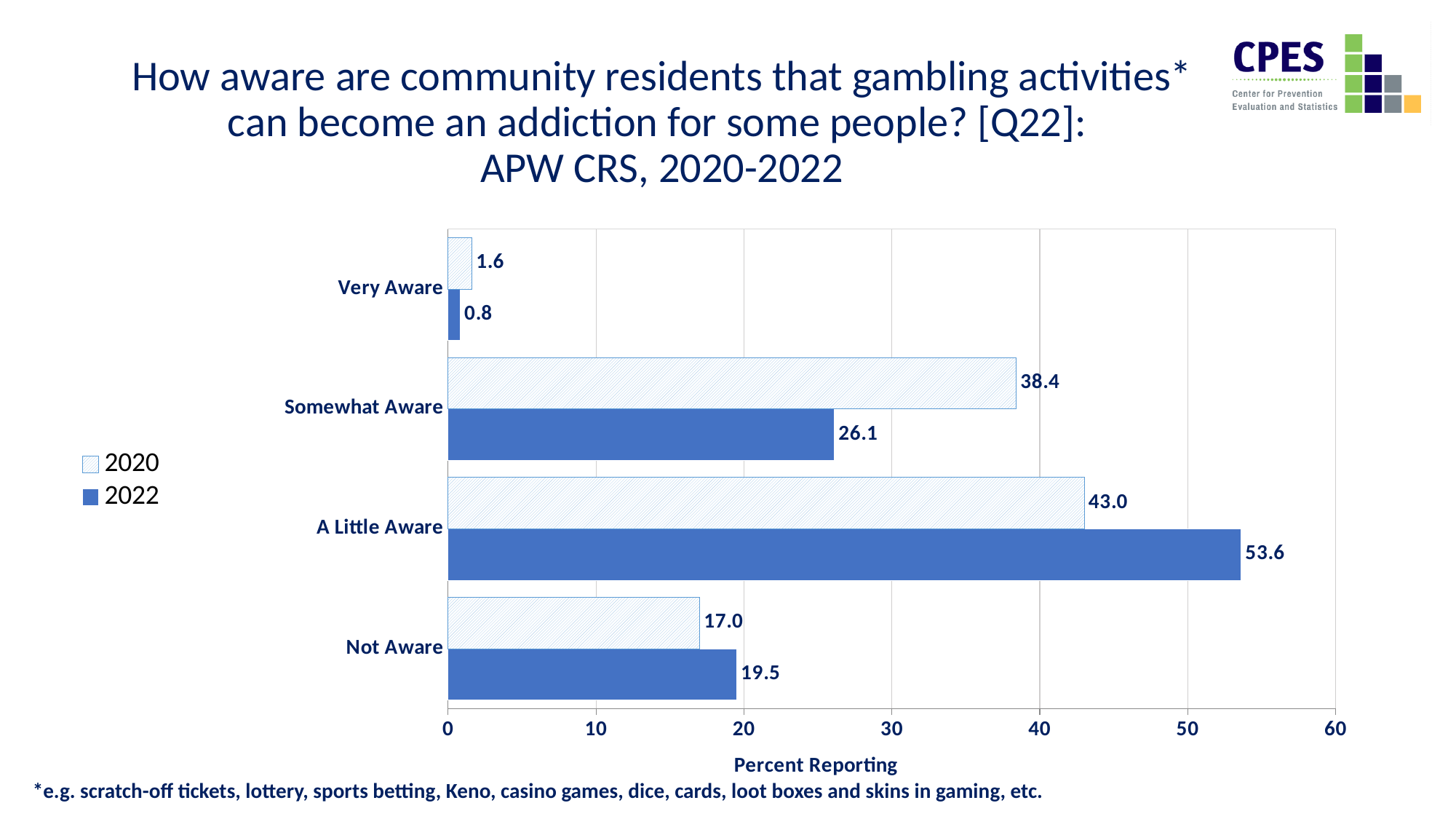
Is the 2022 value for A Little Aware greater or less than 50? greater How many categories are shown on the chart? 4 What is the 2022 value for Very Aware? 0.8 What is the 2020 value for Not Aware? 17.0 What is the 2022 value for A Little Aware? 53.6 Which category has the highest 2022 value? A Little Aware How many series does the legend list? 2 What is the difference between the 2020 and 2022 values for Somewhat Aware? 12.3 Which category has the lowest 2020 value? Very Aware What kind of chart is shown on the slide? bar chart What is the 2020 value for Somewhat Aware? 38.4 Which is larger for Not Aware, the 2020 value or the 2022 value? 2022